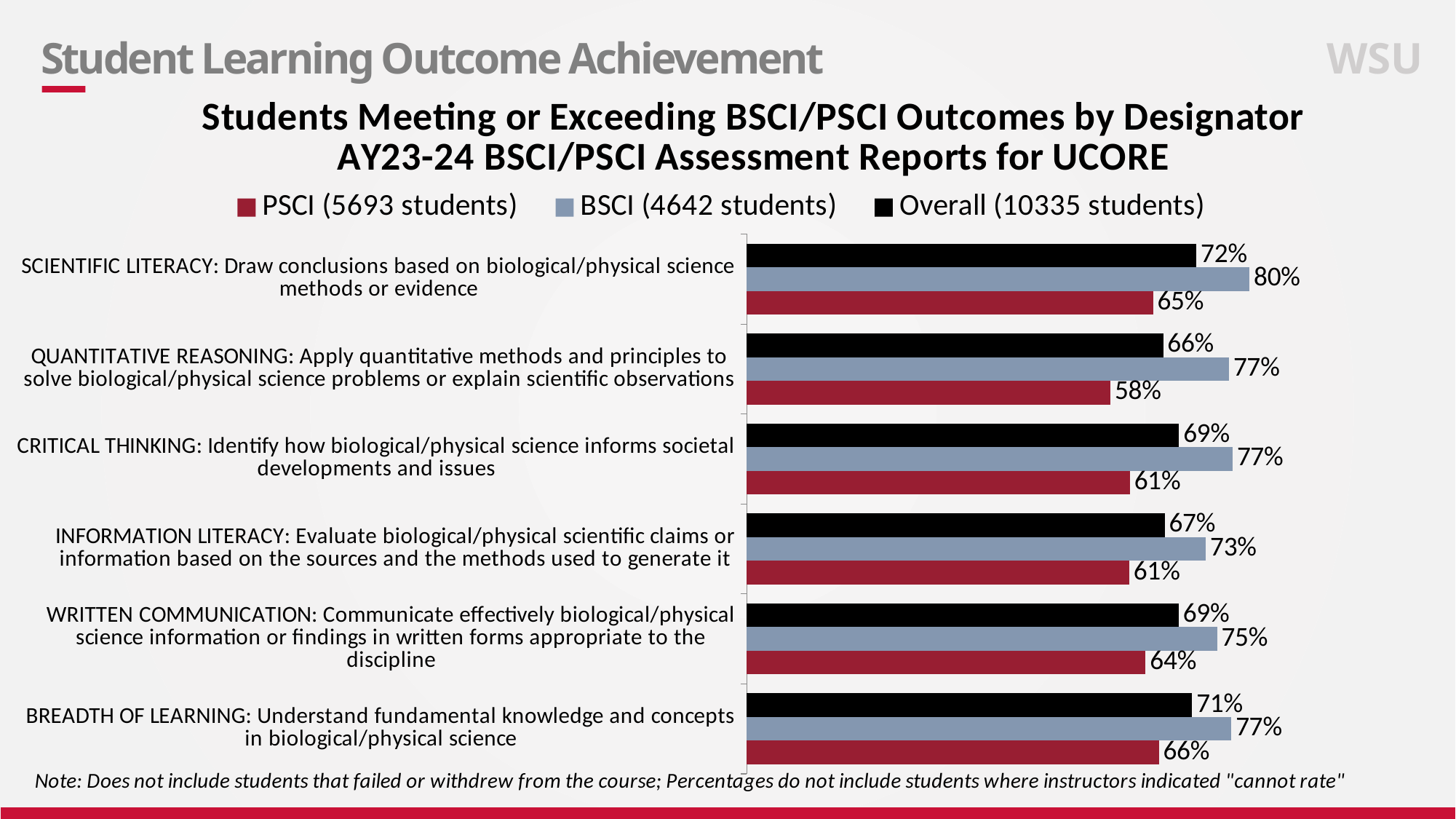
What kind of chart is shown on the slide? Bar chart According to the legend, how many students are in the Overall group? 10335 students What is the difference between the Overall values for Scientific Literacy and Information Literacy? 5% For which outcome is the BSCI value highest? Scientific Literacy What is the Overall value for the Quantitative Reasoning outcome? 66% For which outcome is the PSCI value lowest? Quantitative Reasoning What is the difference between the BSCI and PSCI values for the Quantitative Reasoning outcome? 19% How many series does the legend list? 3 What percentage of BSCI students met or exceeded the Scientific Literacy outcome? 80% How many outcome categories are shown on the chart? 6 Which is larger for the Breadth of Learning outcome, the BSCI value or the PSCI value? BSCI What percentage of PSCI students met or exceeded the Written Communication outcome? 64%